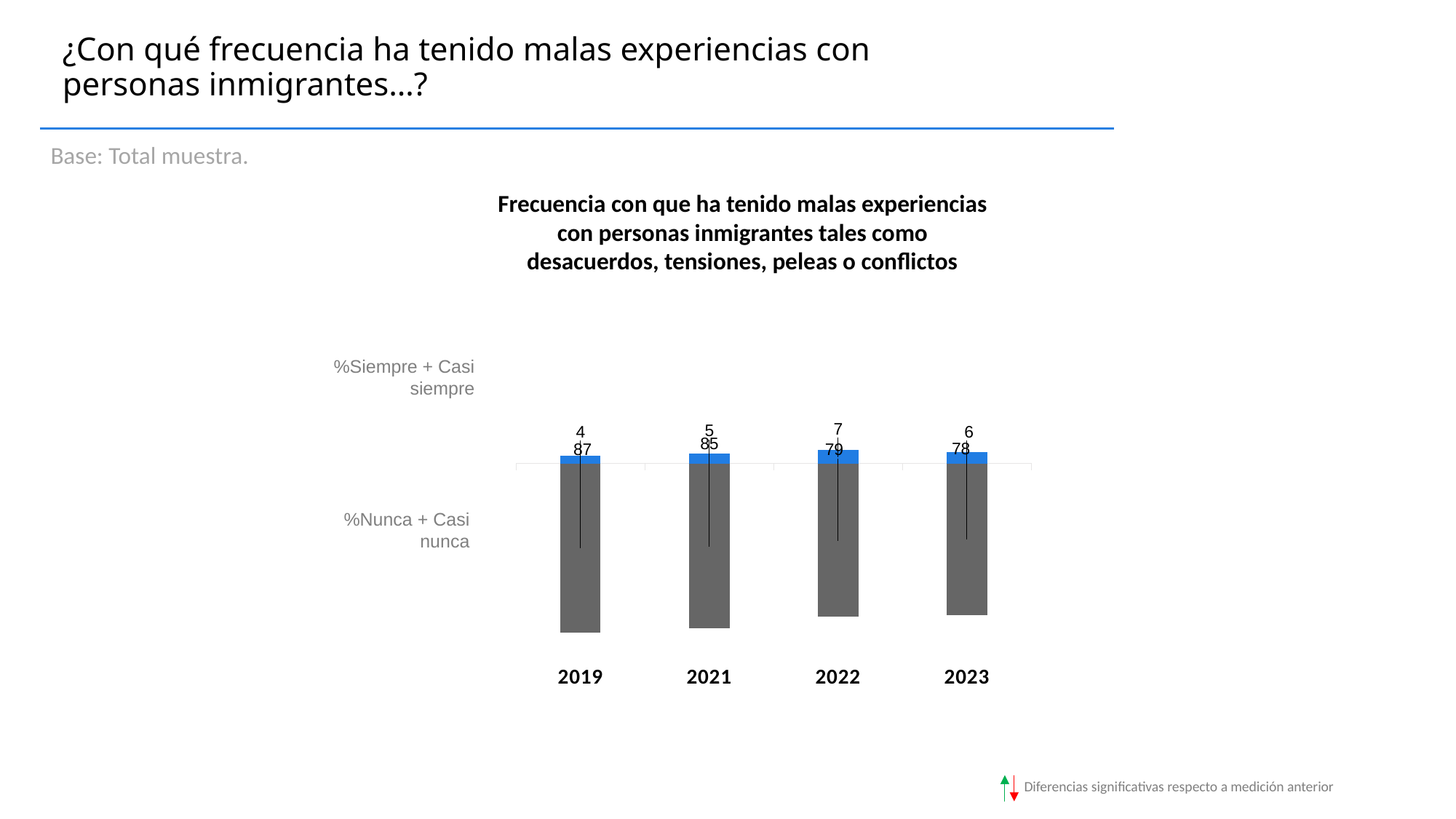
What is the %Nunca + Casi nunca value for 2022? 79 What is the %Nunca + Casi nunca value for 2023? 78 How many years are shown on the x axis of the chart? 4 Does the %Nunca + Casi nunca value rise or fall from 2019 to 2023? Fall What is the %Siempre + Casi siempre value for 2019? 4 What is the difference between the %Nunca + Casi nunca values for 2019 and 2023? 9 What kind of chart is shown on the slide? Bar chart What is the %Siempre + Casi siempre value for 2021? 5 Which year has the lowest %Nunca + Casi nunca value? 2023 Which year has the highest %Siempre + Casi siempre value? 2022 Which year has the highest %Nunca + Casi nunca value? 2019 Which is larger, the %Siempre + Casi siempre value for 2022 or for 2023? 2022